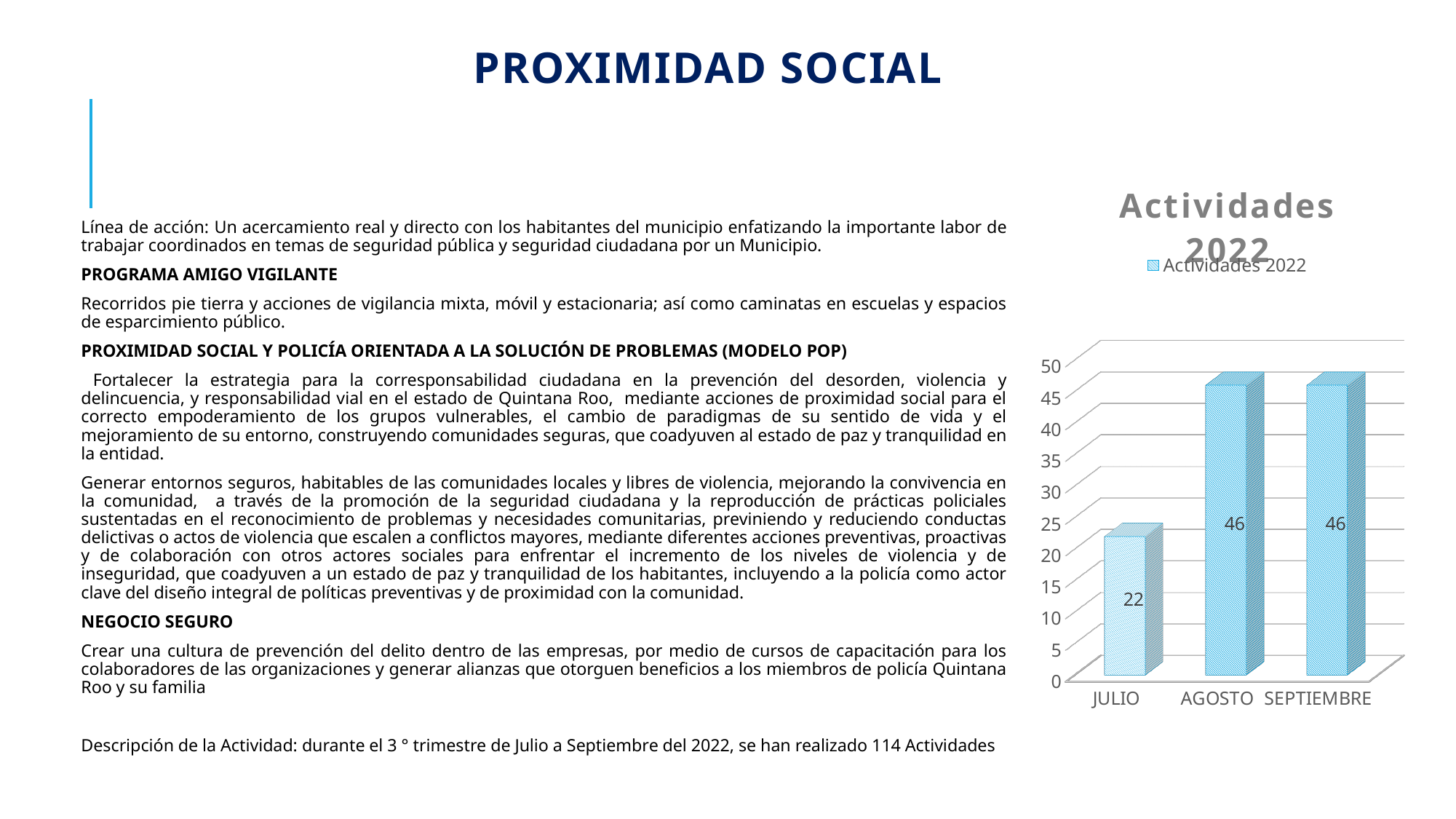
Which month has the lowest value in the Actividades 2022 chart? JULIO What is the title of the chart on the slide? Actividades 2022 How many categories are shown on the x axis of the Actividades 2022 chart? 3 What is the value for AGOSTO in the Actividades 2022 chart? 46 What kind of chart is the Actividades 2022 chart? bar chart Is the value for SEPTIEMBRE in the Actividades 2022 chart greater or less than 40? greater What is the difference between the values for AGOSTO and JULIO in the Actividades 2022 chart? 24 What is the value for JULIO in the Actividades 2022 chart? 22 Is the value for JULIO in the Actividades 2022 chart greater or less than 25? less How many series does the legend of the Actividades 2022 chart list? 1 What is the value for SEPTIEMBRE in the Actividades 2022 chart? 46 Which is larger in the Actividades 2022 chart, the value for JULIO or the value for AGOSTO? AGOSTO